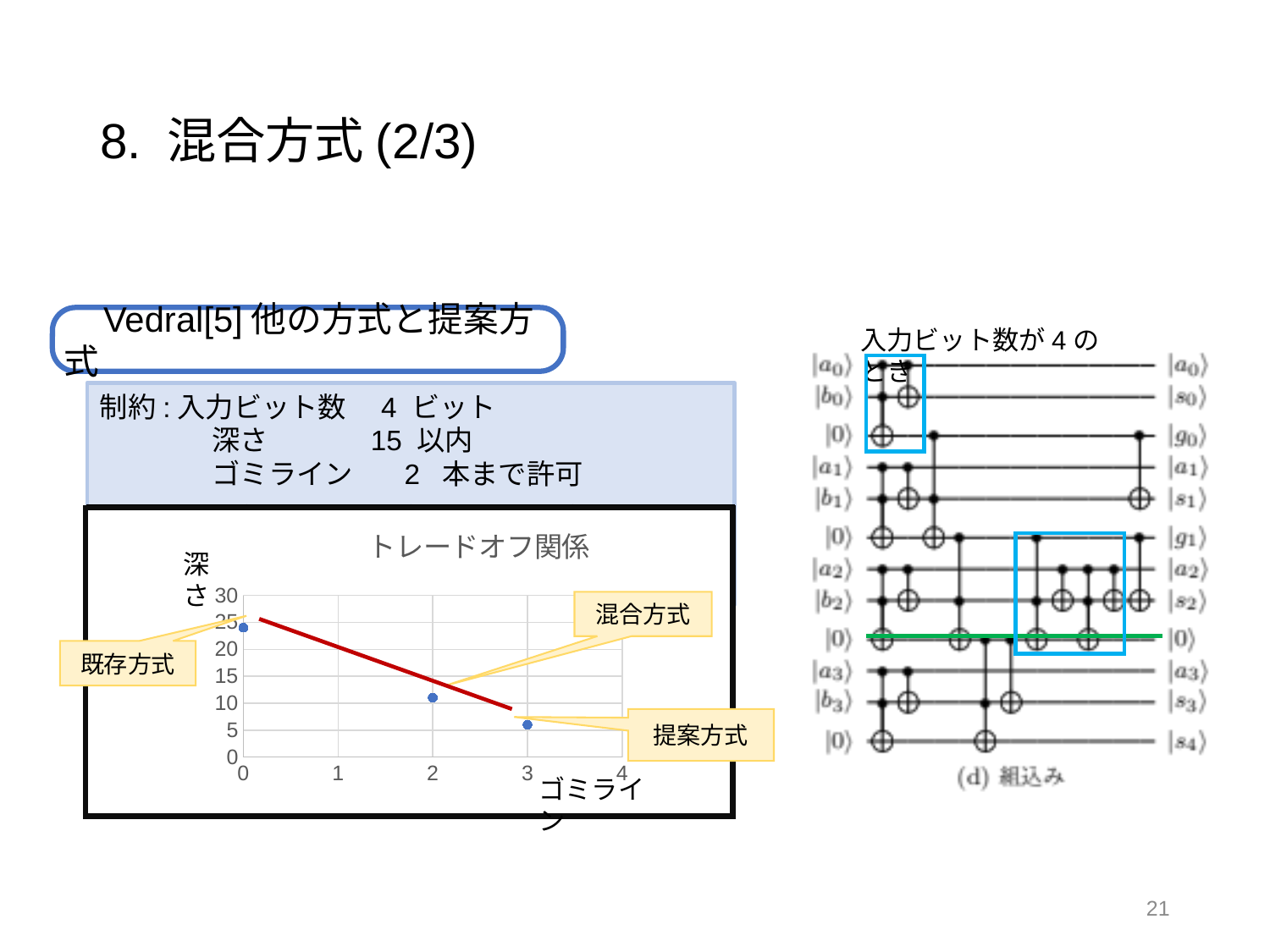
Is the depth value for 混合方式 greater or less than 15? less At what ゴミライン value on the x axis is the 混合方式 point plotted? 2 What is the label of the x axis of the chart? ゴミライン Is the depth value for 既存方式 greater or less than 20? greater Which has a larger depth value, 混合方式 or 提案方式? 混合方式 Which method has the highest depth in the chart? 既存方式 Do the plotted depth values rise or fall as ゴミライン increases along the x axis? fall What kind of chart is shown on the slide? scatter chart How many data points are plotted in the chart? 3 What is the title of the chart? トレードオフ関係 Which method has the lowest depth in the chart? 提案方式 Is the depth value for 提案方式 greater or less than 10? less